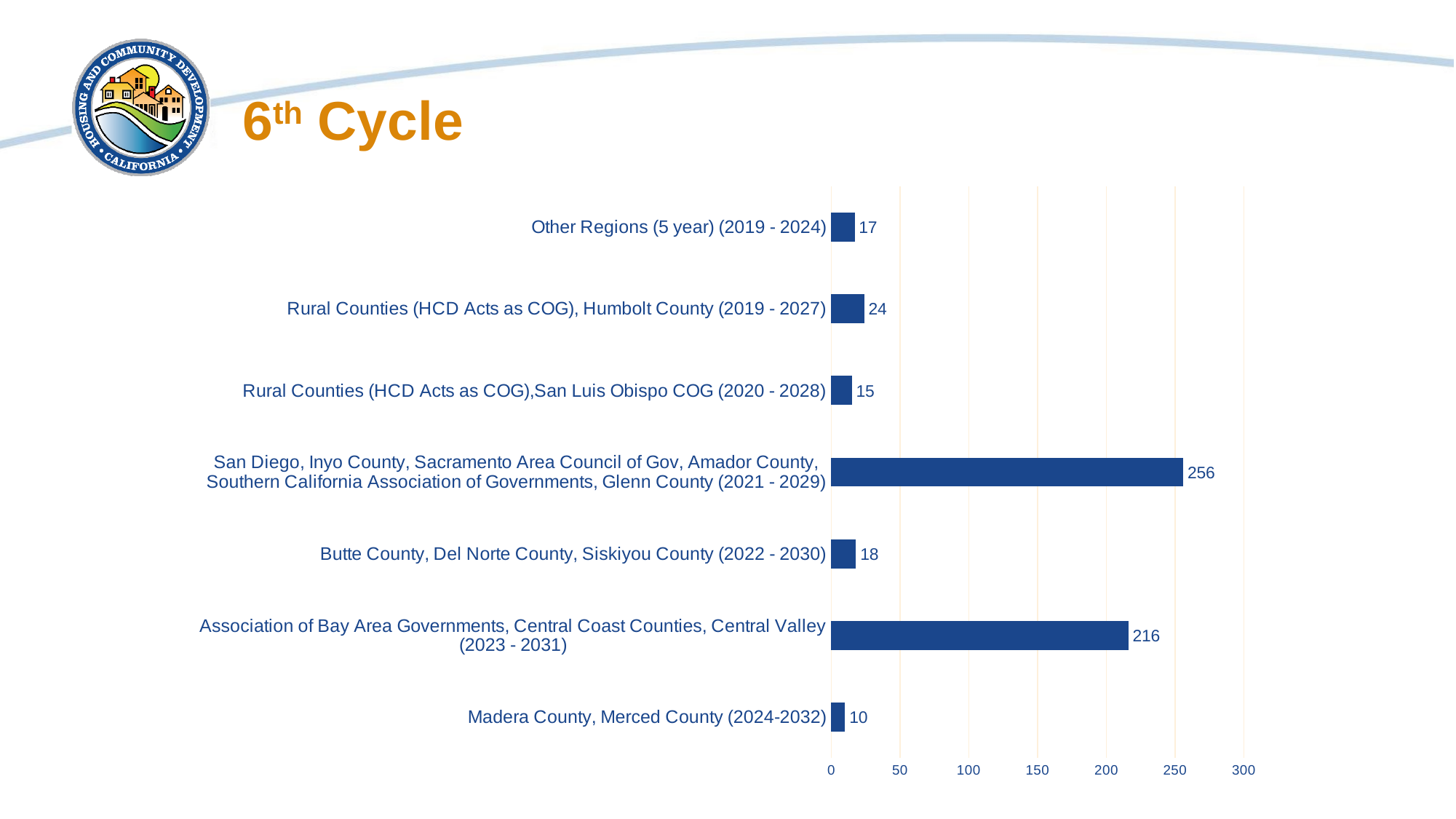
What kind of chart is shown on the slide? Bar chart What is the value for Rural Counties (HCD Acts as COG), Humbolt County (2019 - 2027)? 24 What is the difference between the value for Rural Counties (HCD Acts as COG), Humbolt County (2019 - 2027) and Rural Counties (HCD Acts as COG), San Luis Obispo COG (2020 - 2028)? 9 Which is larger: the value for Other Regions (5 year) (2019 - 2024) or the value for Butte County, Del Norte County, Siskiyou County (2022 - 2030)? Butte County, Del Norte County, Siskiyou County (2022 - 2030) Which category has the lowest value? Madera County, Merced County (2024-2032) Which category has the highest value? San Diego, Inyo County, Sacramento Area Council of Gov, Amador County, Southern California Association of Governments, Glenn County (2021 - 2029) Is the value for Association of Bay Area Governments, Central Coast Counties, Central Valley (2023 - 2031) greater or less than 200? greater What is the difference between the value for the San Diego / SCAG group (2021 - 2029) and the Association of Bay Area Governments group (2023 - 2031)? 40 What is the value for Madera County, Merced County (2024-2032)? 10 How many categories are shown in the chart? 7 What is the value for Other Regions (5 year) (2019 - 2024)? 17 What is the value for Butte County, Del Norte County, Siskiyou County (2022 - 2030)? 18